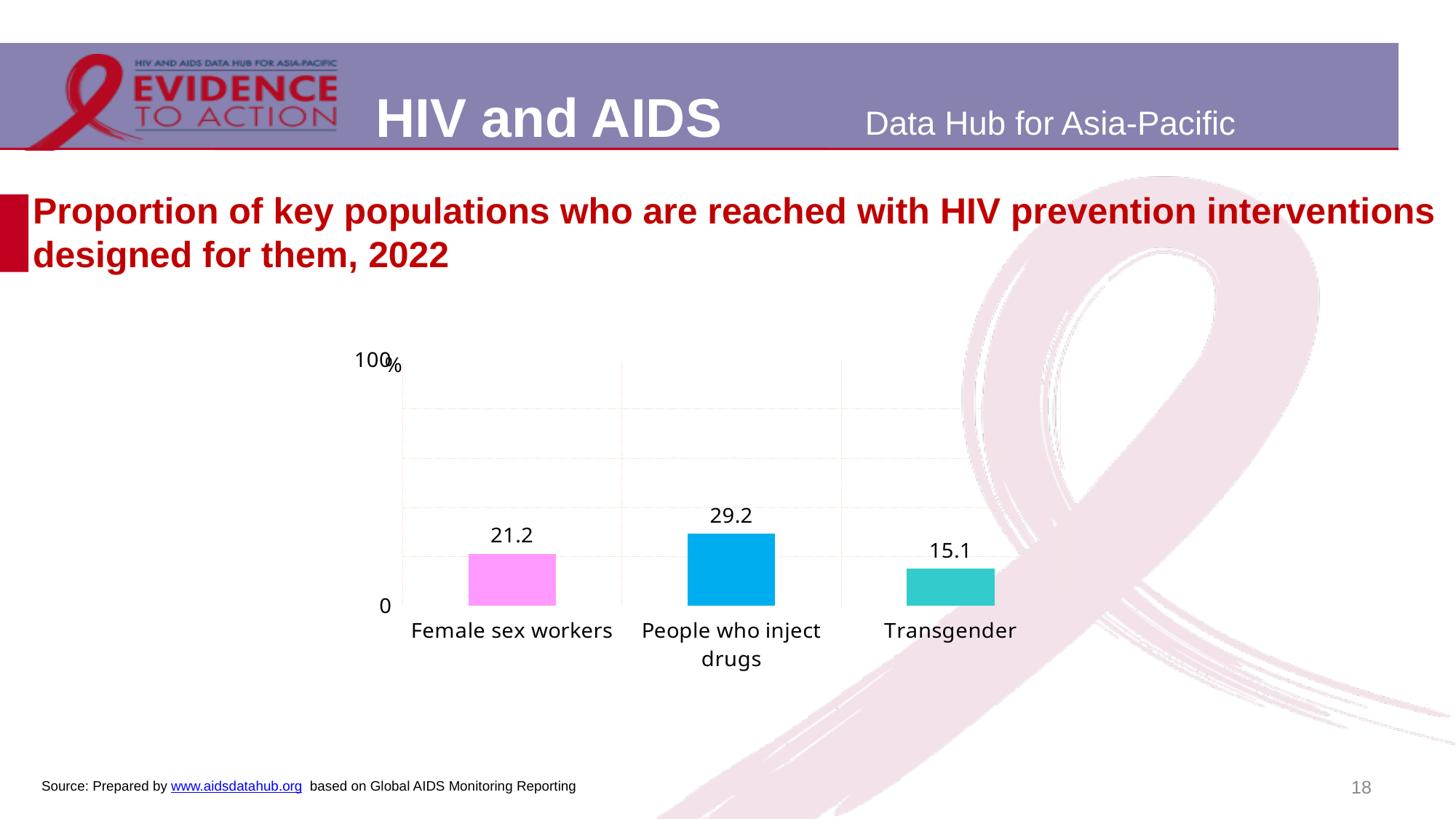
Which key population has the lowest proportion reached? Transgender Which is larger, the value for Female sex workers or the value for People who inject drugs? People who inject drugs What kind of chart is shown on the slide? Bar chart What is the value for People who inject drugs? 29.2 What is the maximum value shown on the y axis? 100 How many key populations are shown in the chart? 3 What year does the chart title refer to? 2022 What is the difference between the values for Female sex workers and Transgender? 6.1 Which key population has the highest proportion reached? People who inject drugs What is the value for Female sex workers? 21.2 What is the value for Transgender? 15.1 What is the difference between the values for People who inject drugs and Transgender? 14.1